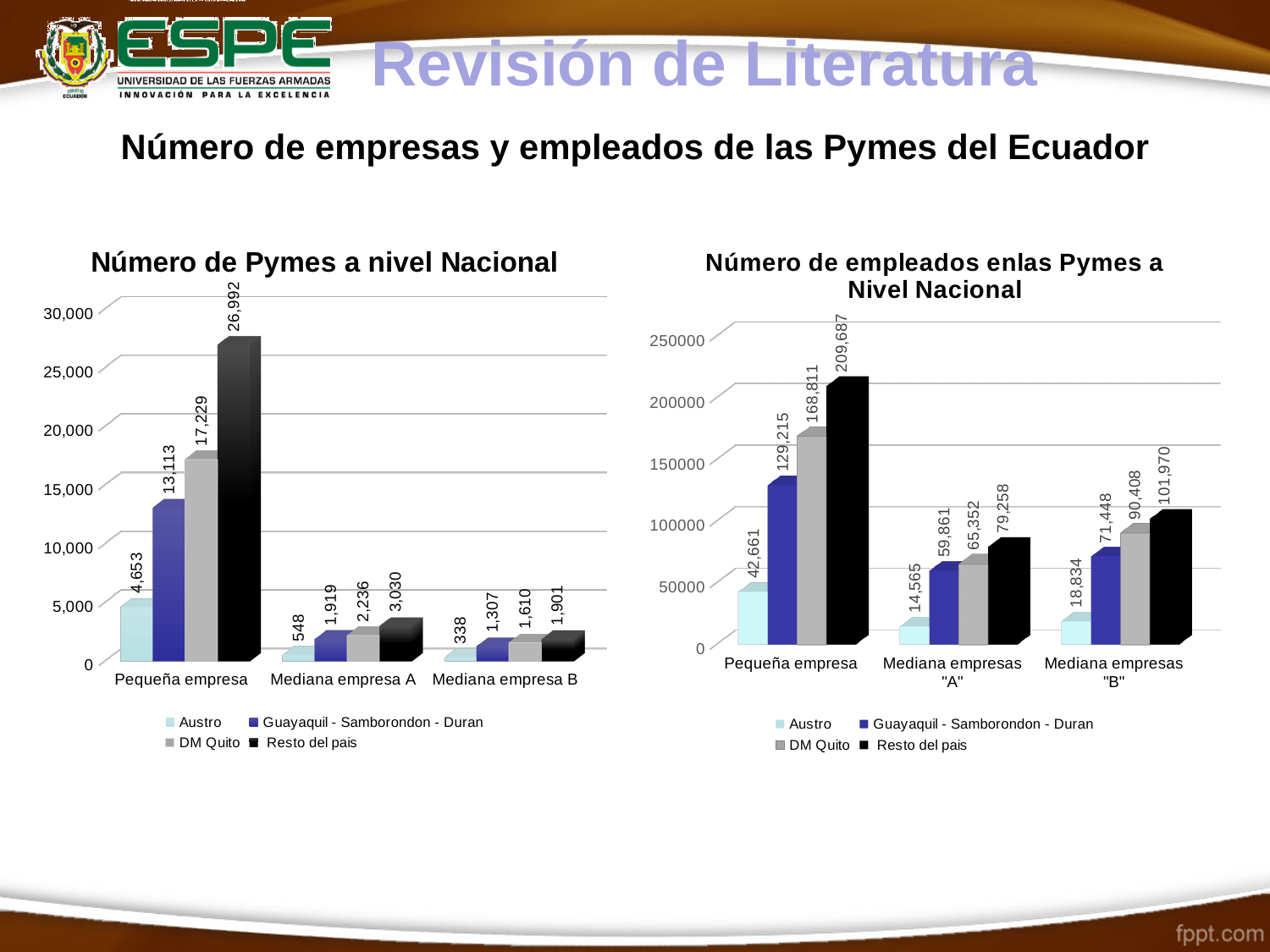
In the 'Número de Pymes a nivel Nacional' chart, what is the difference between DM Quito and Guayaquil - Samborondon - Duran in Pequeña empresa? 4,116 In the 'Número de Pymes a nivel Nacional' chart, how many categories are shown on the x axis? 3 How many series does the legend of the 'Número de empleados enlas Pymes a Nivel Nacional' chart list? 4 In the 'Número de empleados enlas Pymes a Nivel Nacional' chart, what is the value for DM Quito in Pequeña empresa? 168,811 In the 'Número de Pymes a nivel Nacional' chart, which series has the lowest value in Mediana empresa A? Austro What kind of chart is 'Número de Pymes a nivel Nacional'? Bar chart In the 'Número de empleados enlas Pymes a Nivel Nacional' chart, which is larger: Guayaquil - Samborondon - Duran in Mediana empresas "A" or Guayaquil - Samborondon - Duran in Mediana empresas "B"? Mediana empresas "B" In the 'Número de empleados enlas Pymes a Nivel Nacional' chart, which series has the highest value in Mediana empresas "B"? Resto del pais In the 'Número de Pymes a nivel Nacional' chart, what is the value for Resto del pais in Pequeña empresa? 26,992 In the 'Número de empleados enlas Pymes a Nivel Nacional' chart, is the value for Resto del pais in Pequeña empresa greater or less than 200000? greater In the 'Número de Pymes a nivel Nacional' chart, what is the value for Austro in Mediana empresa B? 338 In the 'Número de empleados enlas Pymes a Nivel Nacional' chart, what is the value for Austro in Mediana empresas "A"? 14,565